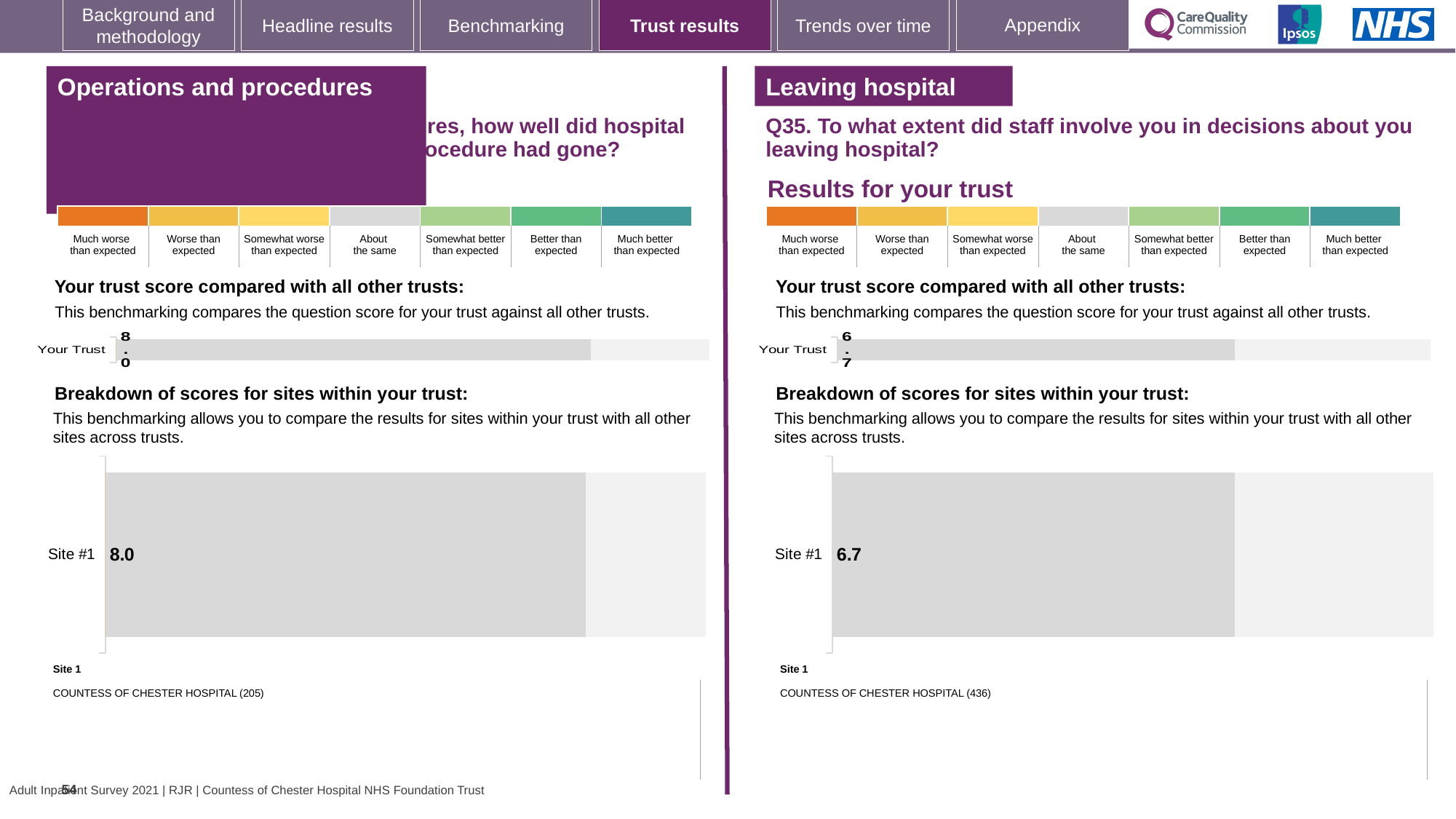
In the Leaving hospital section, which hospital is listed as Site 1 below the breakdown chart? COUNTESS OF CHESTER HOSPITAL (436) In the Operations and procedures section, what score is shown for Site #1 in the breakdown of scores for sites chart? 8.0 In the Leaving hospital section, is the Site #1 score the same as the Your Trust score? Yes How many sites are shown in the breakdown of scores for sites chart in the Leaving hospital section? 1 In the Leaving hospital section, what score is shown for Site #1 in the breakdown of scores for sites chart? 6.7 What kind of chart is used to show the Site #1 score in the Leaving hospital section? Bar chart What is the difference between the Your Trust score in the Operations and procedures section and the Your Trust score in the Leaving hospital section? 1.3 In the Operations and procedures section, what is the score shown for Your Trust on the trust comparison bar chart? 8.0 In the Operations and procedures section, what number appears in parentheses after COUNTESS OF CHESTER HOSPITAL for Site 1? 205 In the Leaving hospital section, what is the score shown for Your Trust on the trust comparison bar chart? 6.7 Which section shows the higher Your Trust score: Operations and procedures or Leaving hospital? Operations and procedures How many categories are shown in the colour scale above the Leaving hospital trust comparison chart, from 'Much worse than expected' to 'Much better than expected'? 7